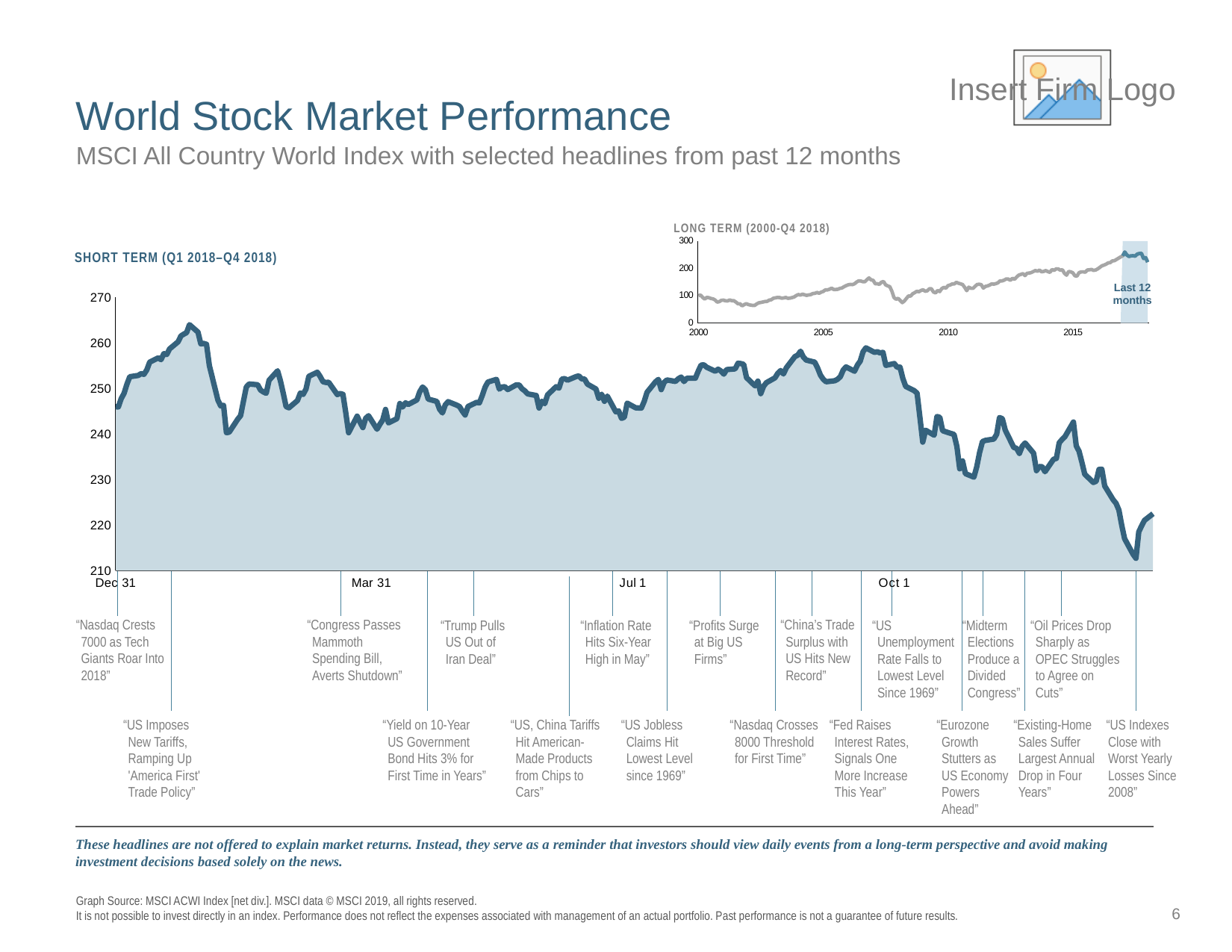
What kind of chart is the long term (2000-Q4 2018) chart? line chart On the short term chart, is the index value at the right end of the line (end of Q4 2018) greater or less than 230? less What label is given to the shaded region at the right of the long term chart? Last 12 months How many date labels are shown on the x axis of the short term chart? 4 On the short term chart, is the index value at Dec 31 greater or less than 240? greater On the long term chart, is the index value in 2000 greater or less than 200? less On the short term chart, does the index rise or fall between Oct 1 and the end of the chart? fall What kind of chart is the short term (Q1 2018–Q4 2018) chart? area chart On the long term chart, does the index generally rise or fall from 2000 to the end of the chart? rise